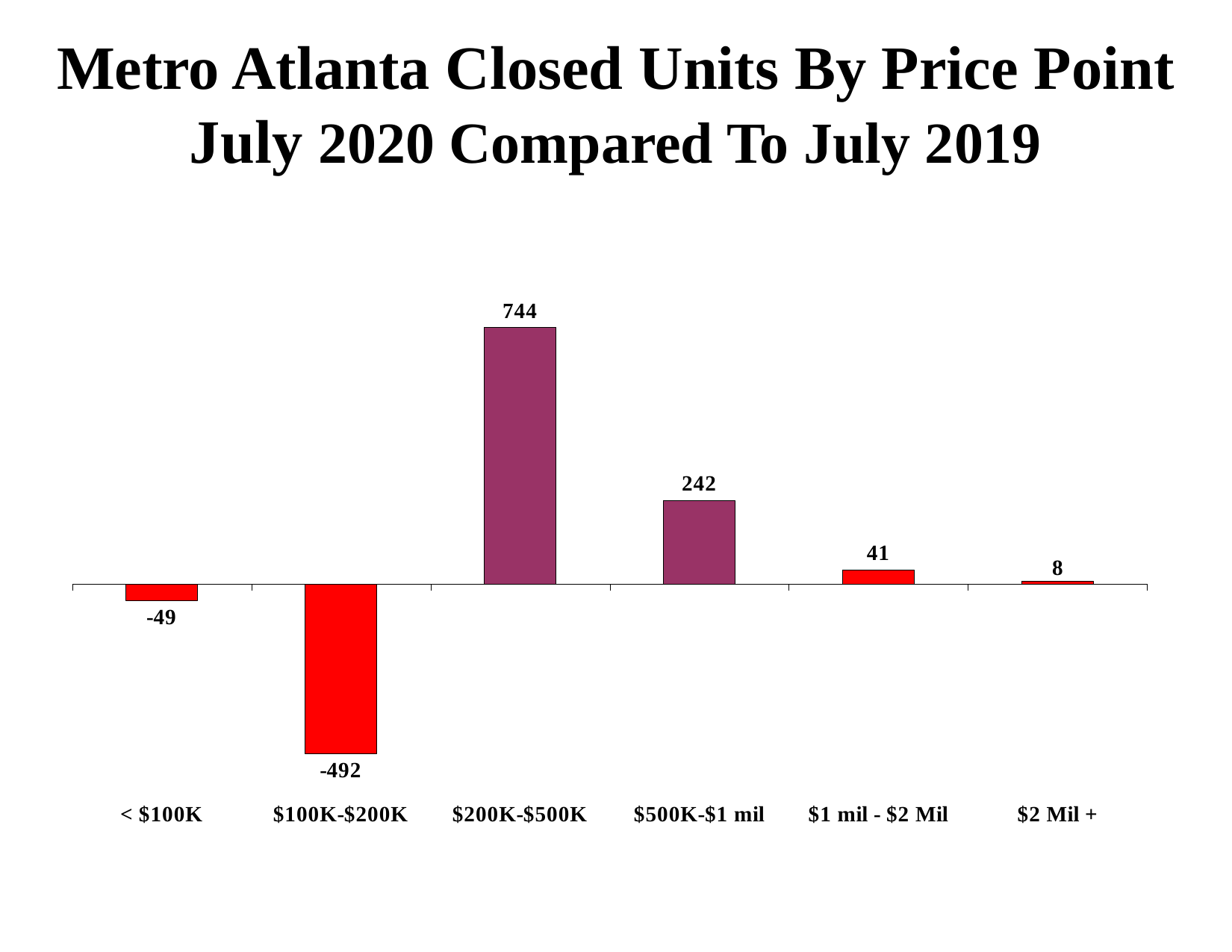
What is the value for the $2 Mil + price point? 8 Which price point has the lowest value? $100K-$200K Which price point has the highest value? $200K-$500K What kind of chart is shown on the slide? bar chart What is the difference between the values for $200K-$500K and $500K-$1 mil? 502 How many price points have a negative value? 2 Which is larger, the value for $500K-$1 mil or the value for $1 mil - $2 Mil? $500K-$1 mil How many price point categories are shown on the chart? 6 What is the difference between the values for $1 mil - $2 Mil and $2 Mil +? 33 What is the value for the $200K-$500K price point? 744 What is the value for the $100K-$200K price point? -492 What is the value for the < $100K price point? -49